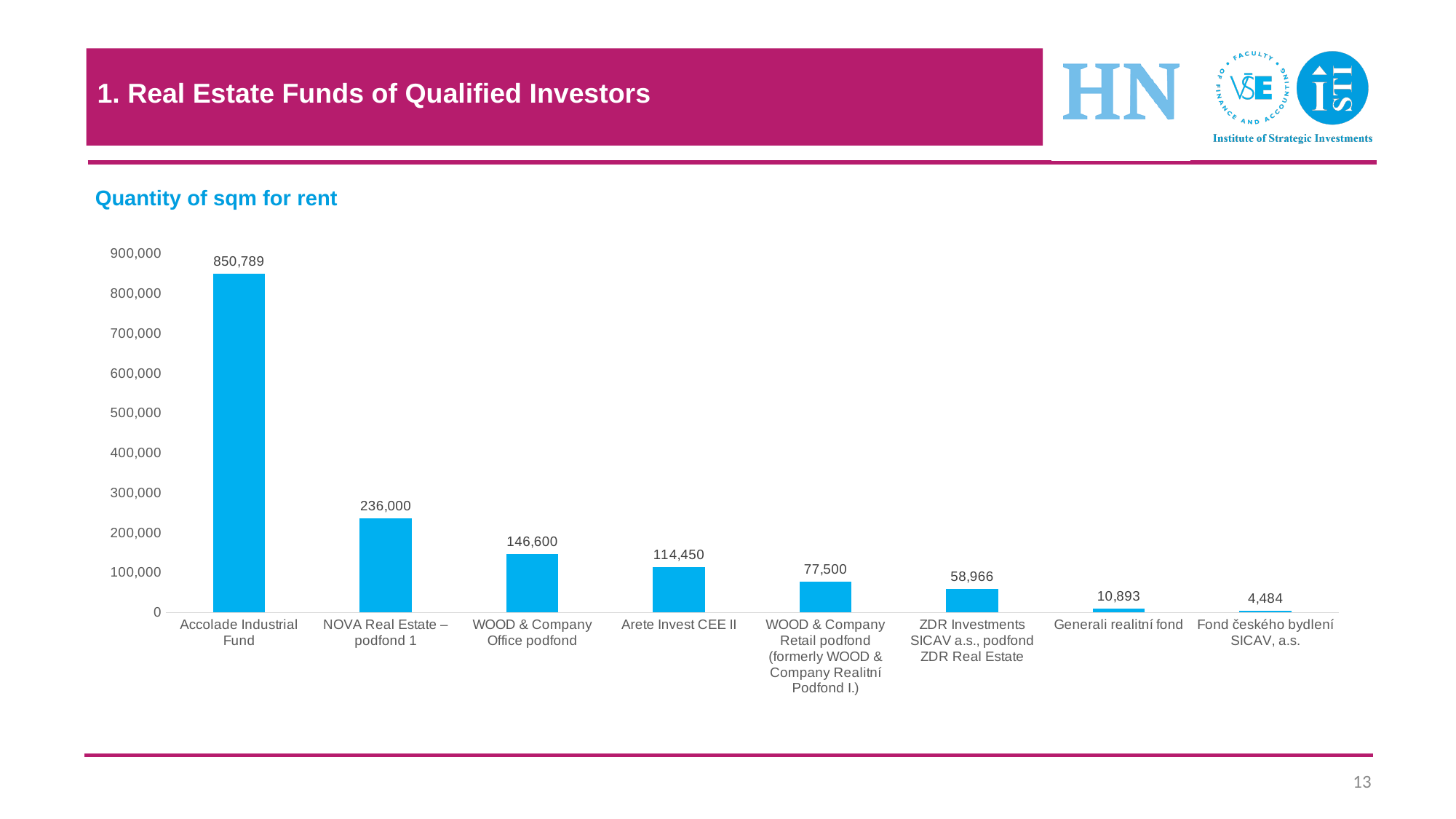
Which fund has the highest quantity of sqm for rent? Accolade Industrial Fund What is the difference in sqm for rent between NOVA Real Estate – podfond 1 and Arete Invest CEE II? 121,550 Which has more sqm for rent: WOOD & Company Retail podfond or ZDR Investments SICAV a.s., podfond ZDR Real Estate? WOOD & Company Retail podfond What kind of chart is shown on the slide? Bar chart What is the quantity of sqm for rent for Generali realitní fond? 10,893 Is the value for NOVA Real Estate – podfond 1 greater or less than 200,000? greater Which fund has the lowest quantity of sqm for rent? Fond českého bydlení SICAV, a.s. What is the title of the chart? Quantity of sqm for rent How many funds are shown in the chart? 8 Do the values rise or fall from left to right across the chart? Fall What is the quantity of sqm for rent for Accolade Industrial Fund? 850,789 What is the quantity of sqm for rent for WOOD & Company Office podfond? 146,600